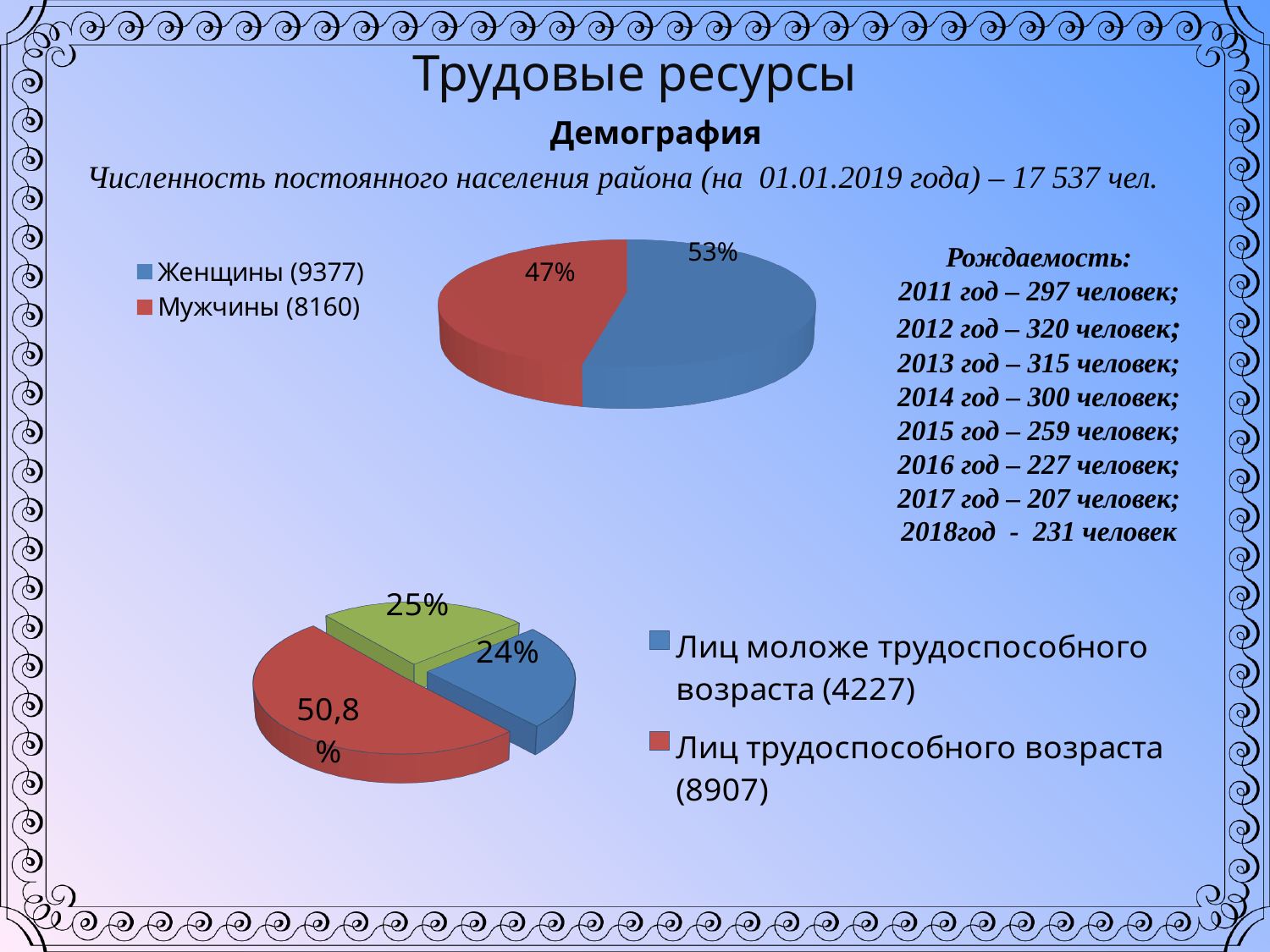
In the top pie chart, what percentage is shown for Женщины? 53% What kind of chart is the top chart on the slide? pie chart How many entries does the legend of the top pie chart list? 2 In the top pie chart, what is the difference in percentage points between Женщины and Мужчины? 6 In the bottom pie chart, what percentage is shown for Лиц моложе трудоспособного возраста? 24% In the bottom pie chart, what percentage is shown for Лиц трудоспособного возраста? 50,8% In the top pie chart, what percentage is shown for Мужчины? 47% In the top pie chart, which category has the larger share? Женщины In the bottom pie chart, which slice is the largest? Лиц трудоспособного возраста How many slices does the bottom pie chart have? 3 What kind of chart is the bottom chart on the slide? pie chart In the top pie chart, what colour is the Мужчины slice? red